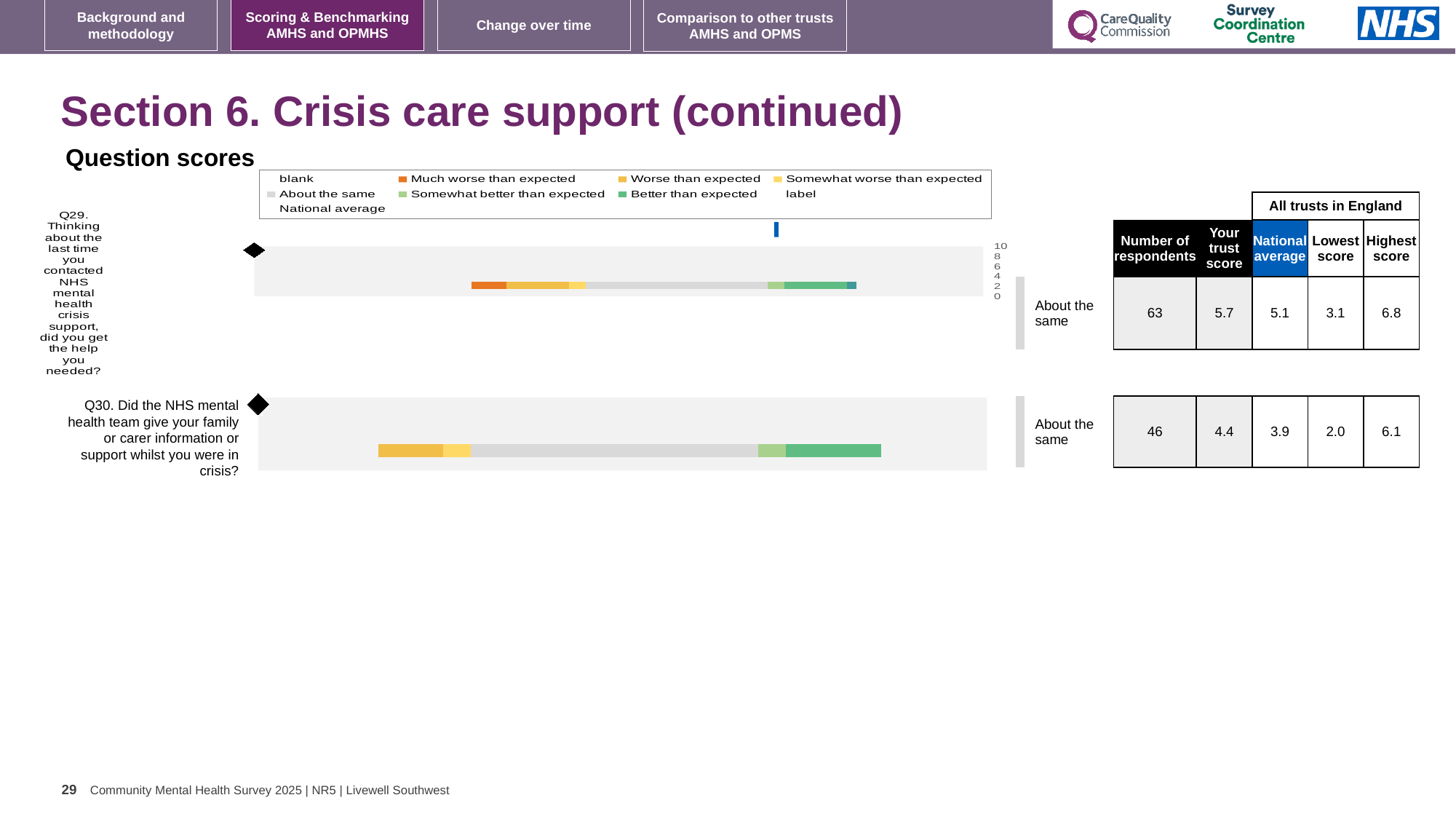
How many respondents answered Q30? 46 Which colour in the legend represents 'Better than expected'? green Which question has the higher trust score, Q29 or Q30? Q29 How many questions (bars) are plotted on the slide? 2 What is the national average for Q30 shown in the table beside the chart? 3.9 What benchmark category is shown next to the bar for Q29? About the same What is the highest score across all trusts in England for Q29? 6.8 What is the trust score for Q29 shown in the table beside the chart? 5.7 Which colour in the legend represents 'Much worse than expected'? orange What is the difference between the trust score and the national average for Q29? 0.6 What benchmark category is shown next to the bar for Q30? About the same What kind of chart is used to show the question scores for Q29 and Q30? bar chart